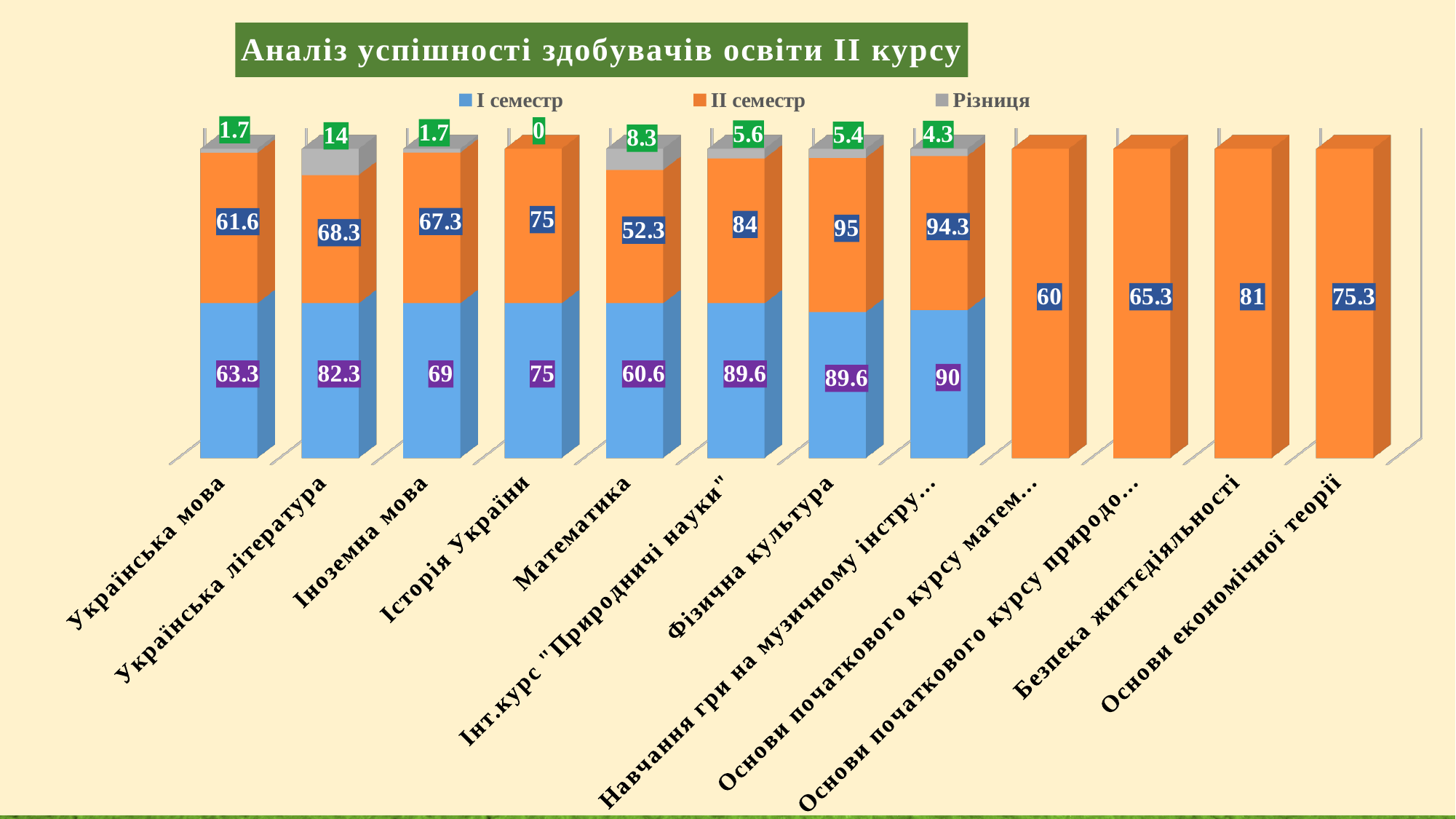
How many series does the legend list? 3 What is the difference between the І семестр and ІІ семестр values for Іноземна мова? 1.7 What is the ІІ семестр value for Основи економічної теорії? 75.3 What is the Різниця value for Українська література? 14 Which is larger for Фізична культура: the І семестр value or the ІІ семестр value? ІІ семестр What is the ІІ семестр value for Безпека життєдіяльності? 81 What is the value of the ІІ семестр series for Математика? 52.3 Which category has the largest Різниця value? Українська література What type of chart is shown on the slide? Stacked bar chart What is the value of the І семестр series for Українська мова? 63.3 Which category has the highest ІІ семестр value? Фізична культура Which category has the lowest ІІ семестр value? Математика